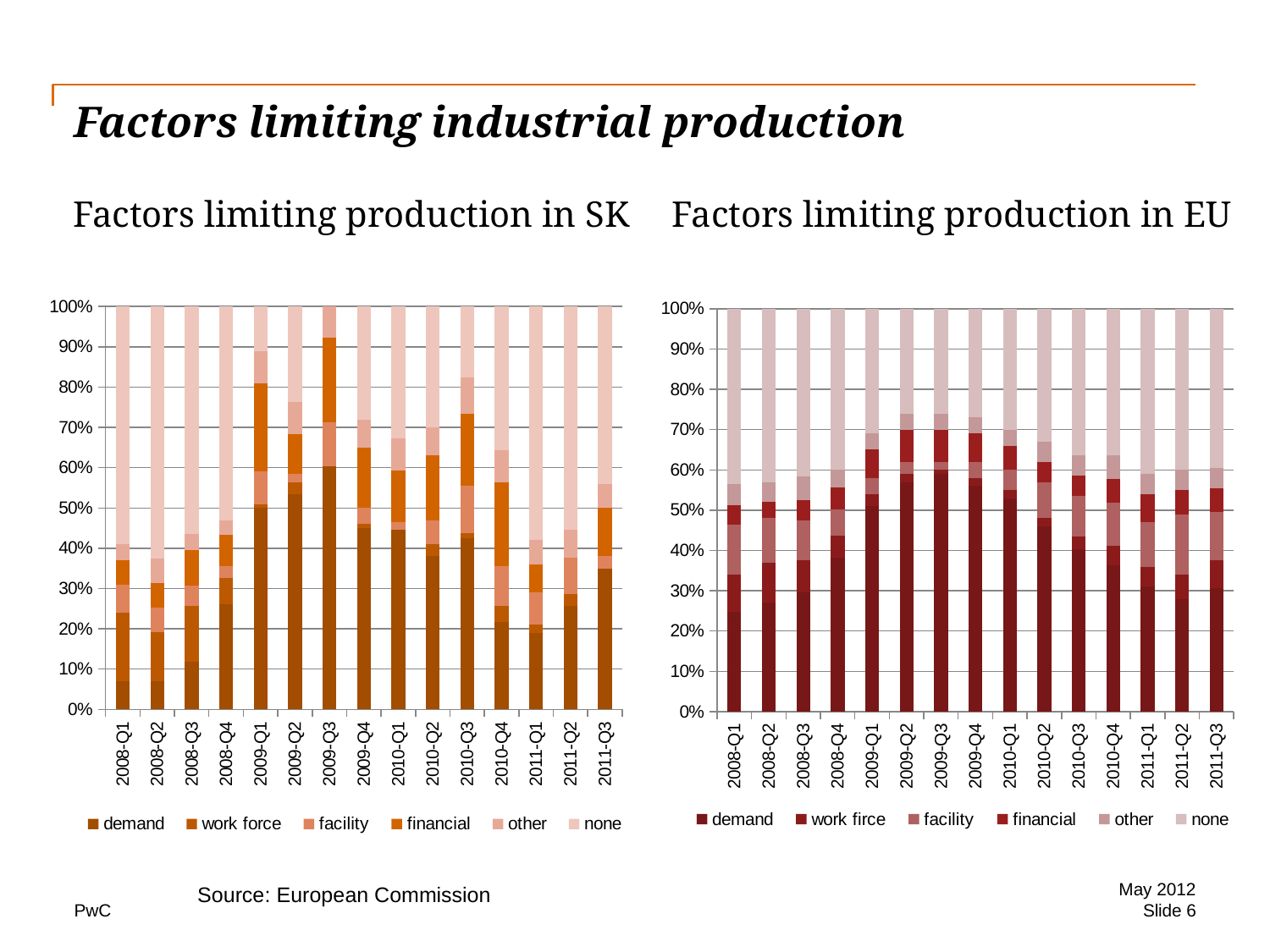
In the 'Factors limiting production in EU' chart, which quarter has the lowest demand value? 2008-Q1 In the 'Factors limiting production in SK' chart, is the demand value for 2008-Q1 greater or less than 10%? less How many quarters are shown on the x axis of the 'Factors limiting production in EU' chart? 15 In the 'Factors limiting production in EU' chart, is the demand value for 2009-Q3 greater or less than 50%? greater In the 'Factors limiting production in EU' chart, is the demand value larger in 2009-Q1 or in 2008-Q1? 2009-Q1 In the 'Factors limiting production in EU' chart, does the demand value rise or fall from 2009-Q3 to 2011-Q1? fall What kind of chart is 'Factors limiting production in SK'? Stacked bar chart In the 'Factors limiting production in SK' chart, what is the total of the stacked bar for 2010-Q2? 100% In the 'Factors limiting production in SK' chart, which quarter has the highest demand value? 2009-Q3 In the 'Factors limiting production in EU' chart, is the demand value for 2008-Q1 greater or less than 30%? less How many series does the legend of the 'Factors limiting production in SK' chart list? 6